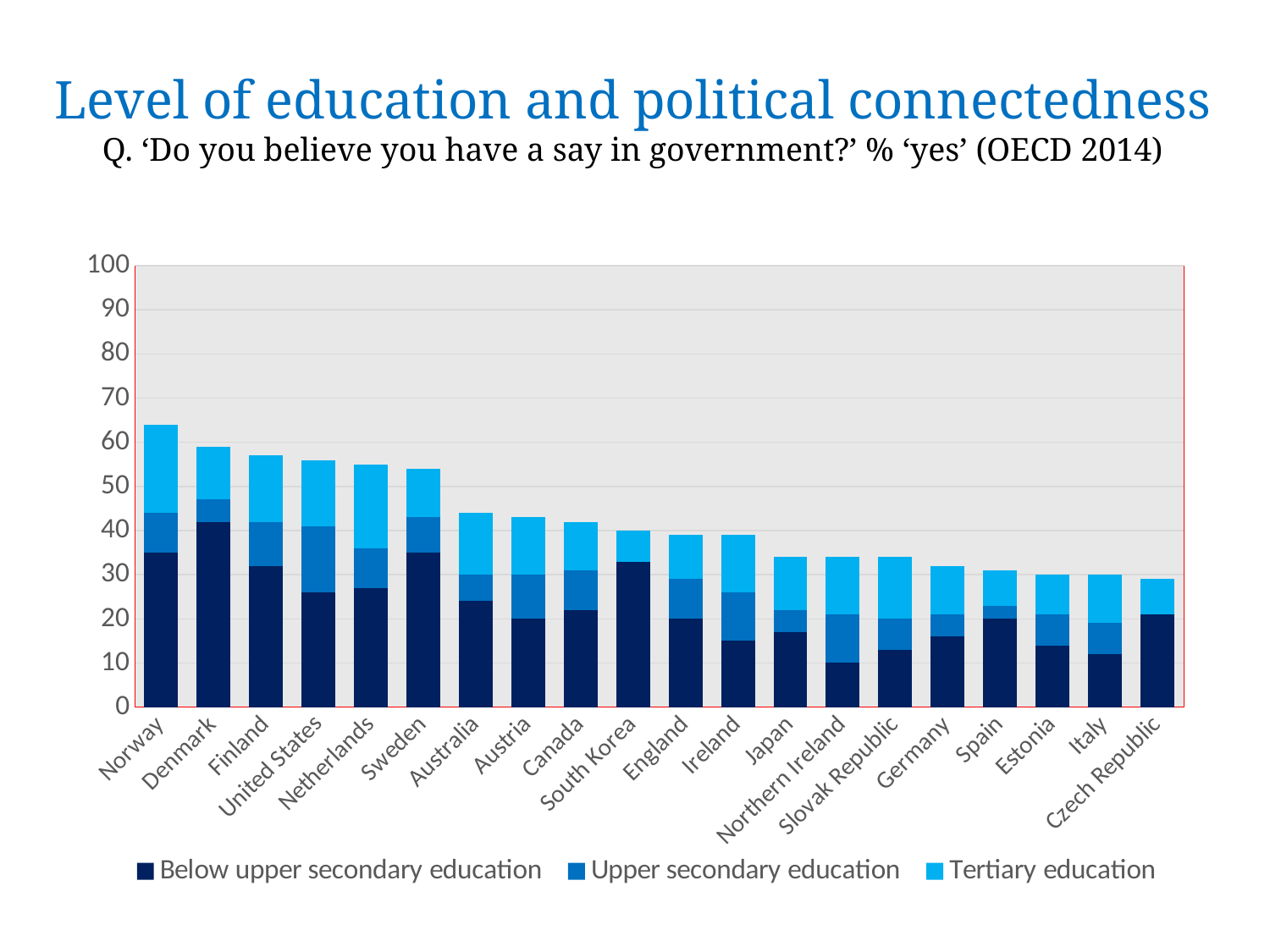
Is the total bar for Norway greater or less than 60? greater Which country has the tallest 'Below upper secondary education' segment? Denmark How many countries are shown on the x axis of the chart? 20 What kind of chart is shown on the slide? Stacked bar chart Is the 'Below upper secondary education' value for Ireland greater or less than 20? less Which has the larger total bar, Norway or Sweden? Norway How many series does the legend list? 3 Is the 'Below upper secondary education' value for Denmark greater or less than 40? greater Which series is shown in the lightest blue in the legend? Tertiary education Which country has the highest total bar? Norway Do the total bar heights generally rise or fall from left to right along the x axis? fall